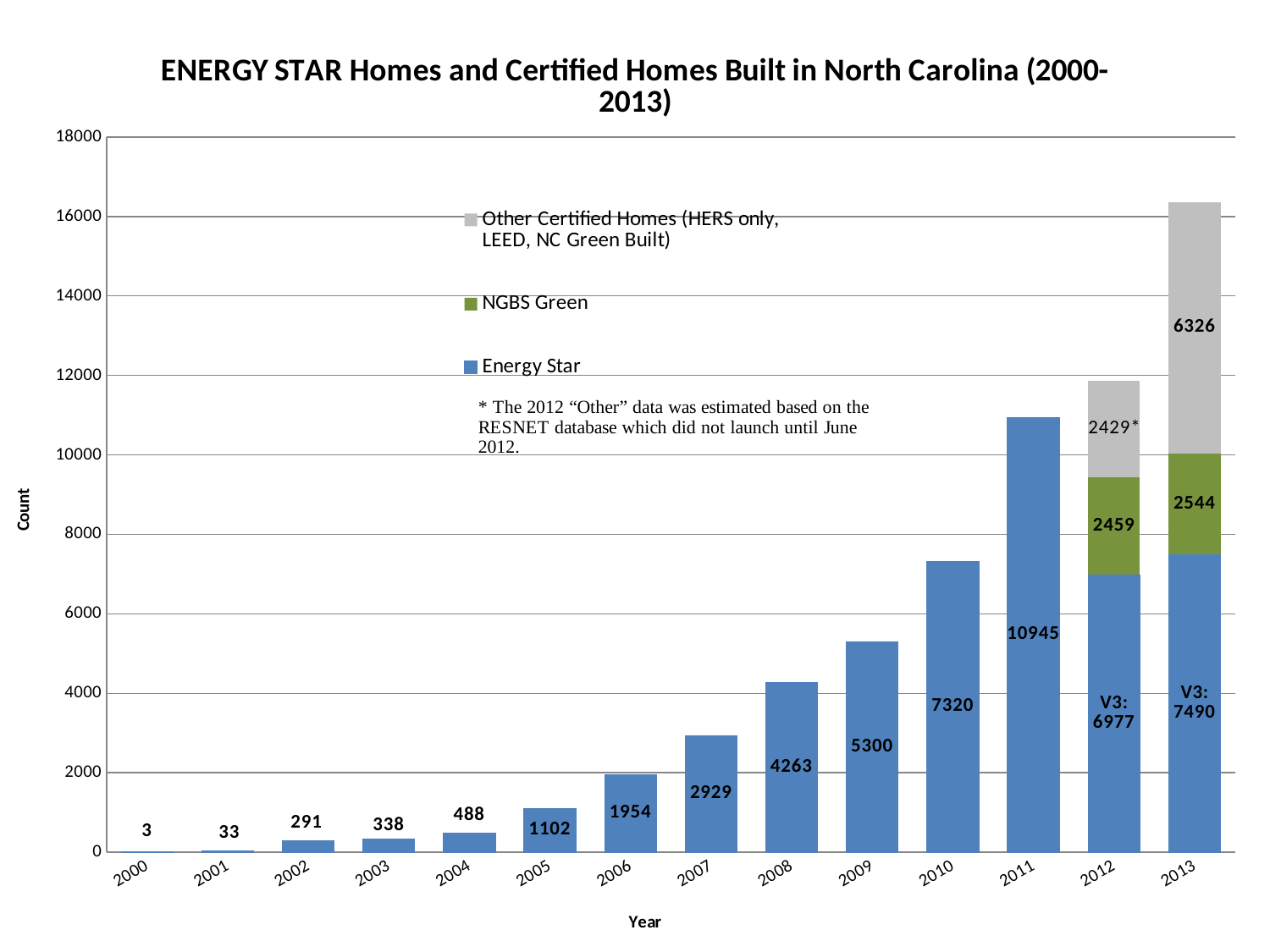
What kind of chart is shown on the slide? Stacked bar chart What is the Energy Star value for 2011? 10945 What is the NGBS Green value for 2013? 2544 Which year has the lowest Energy Star value? 2000 How many years are shown on the x axis? 14 What is the difference between the Energy Star values for 2011 and 2010? 3625 What is the Other Certified Homes value for 2013? 6326 What is the total of the stacked bar for 2013? 16360 How many series does the legend list? 3 Which year has the highest Energy Star value? 2011 Do the Energy Star values rise or fall from 2000 to 2011? Rise Which year has the larger Energy Star value, 2012 or 2013? 2013